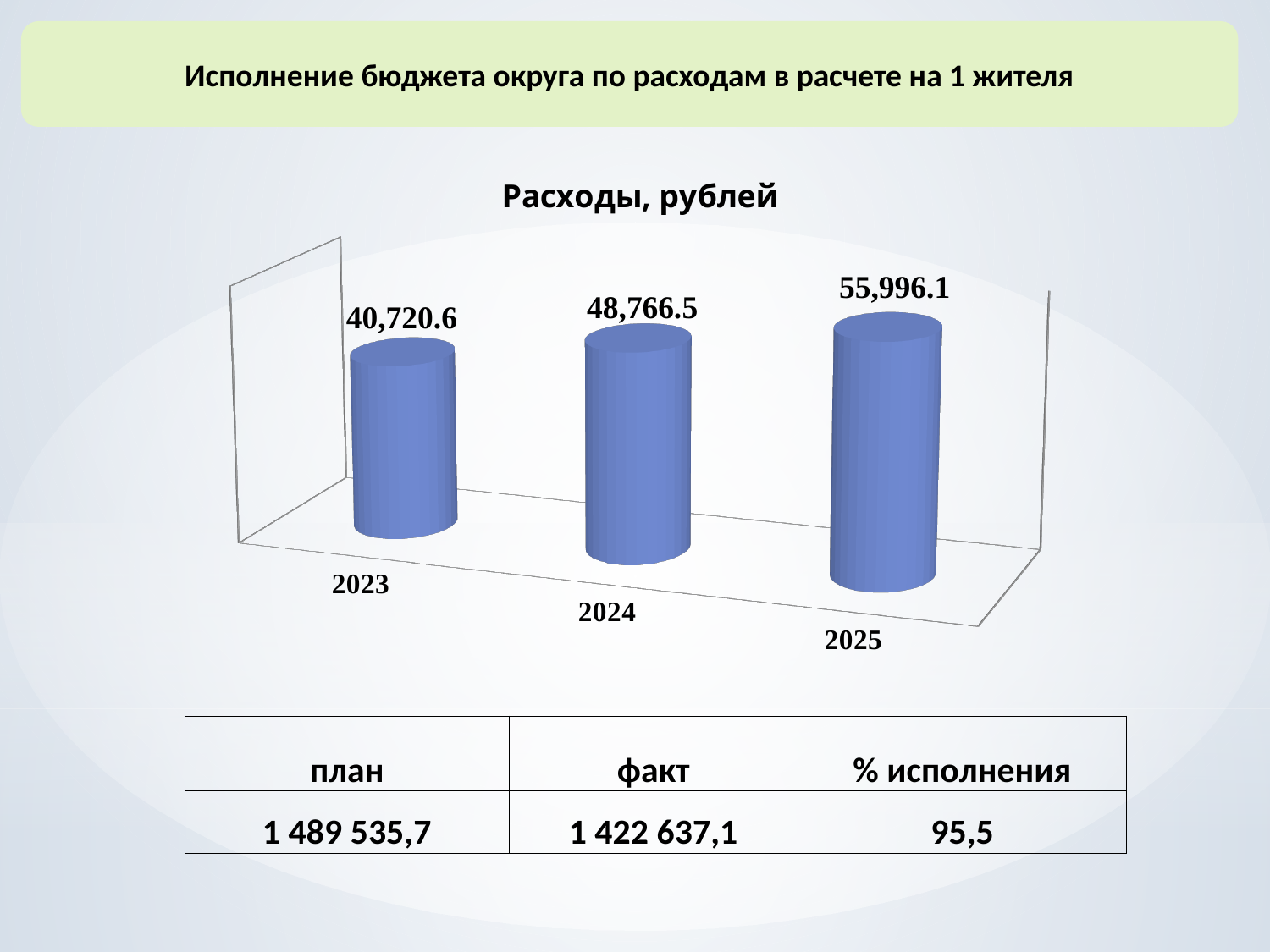
What is the difference between the 2024 and 2023 values in the chart "Расходы, рублей"? 8,045.9 What is the value for 2023 in the chart "Расходы, рублей"? 40,720.6 How many years are shown in the chart "Расходы, рублей"? 3 What is the difference between the 2025 and 2024 values in the chart "Расходы, рублей"? 7,229.6 Which is larger in the chart "Расходы, рублей": the value for 2023 or the value for 2024? 2024 Which year has the lowest value in the chart "Расходы, рублей"? 2023 What is the difference between the 2025 and 2023 values in the chart "Расходы, рублей"? 15,275.5 Which year has the highest value in the chart "Расходы, рублей"? 2025 What kind of chart is "Расходы, рублей"? Bar chart What is the value for 2024 in the chart "Расходы, рублей"? 48,766.5 What is the value for 2025 in the chart "Расходы, рублей"? 55,996.1 Do the values in the chart "Расходы, рублей" rise or fall from 2023 to 2025? Rise